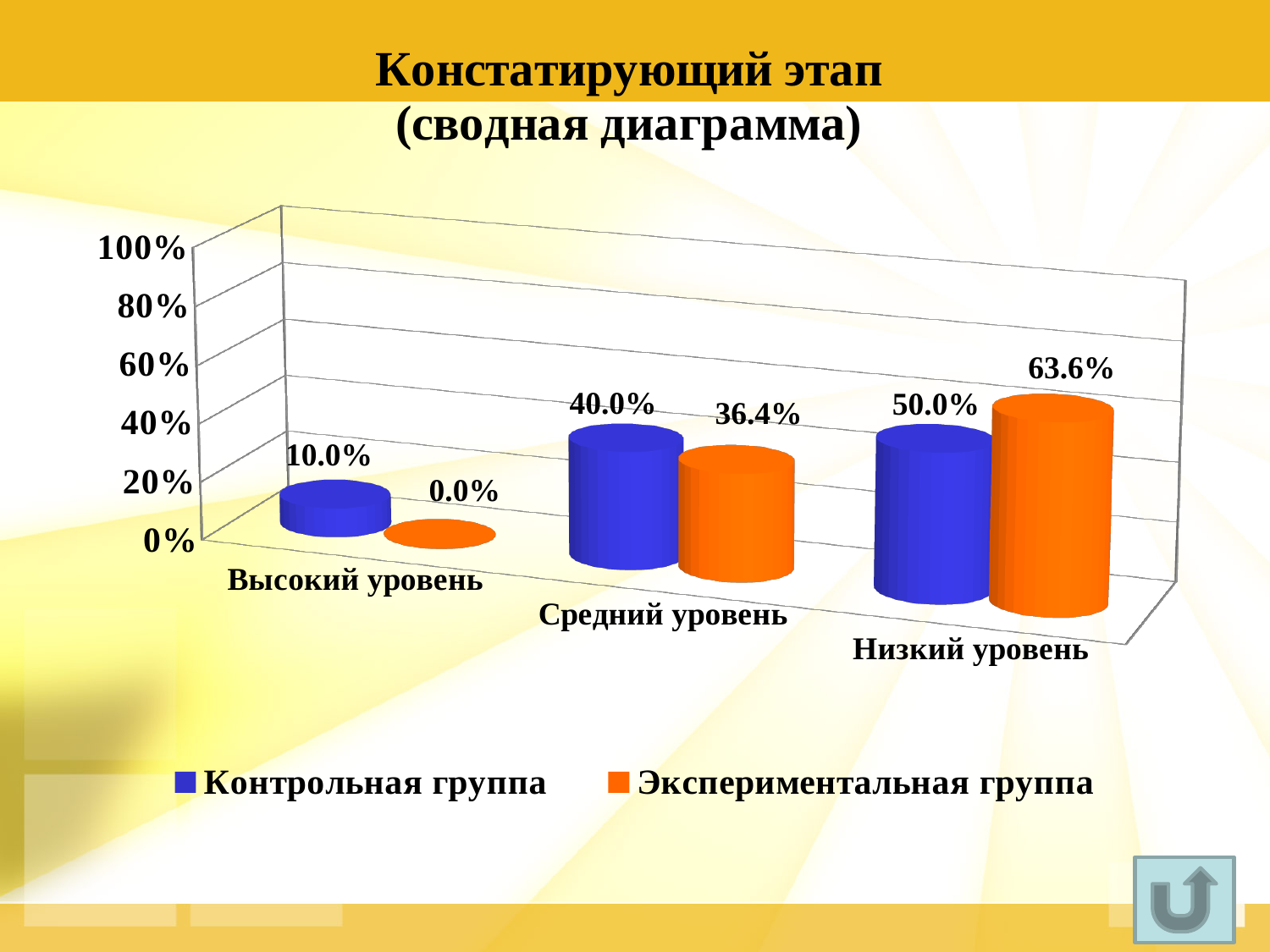
Which category has the lowest value for Контрольная группа? Высокий уровень What kind of chart is shown on the slide? Bar chart How many series does the legend list? 2 At Средний уровень, which group has the larger value? Контрольная группа Which colour represents Экспериментальная группа in the chart? Orange What is the value for Контрольная группа at Высокий уровень? 10.0% What is the value for Экспериментальная группа at Низкий уровень? 63.6% Which category has the highest value for Экспериментальная группа? Низкий уровень What is the value for Экспериментальная группа at Высокий уровень? 0.0% What is the value for Контрольная группа at Средний уровень? 40.0% What is the difference between Экспериментальная группа and Контрольная группа at Низкий уровень? 13.6% How many categories are shown on the x axis? 3